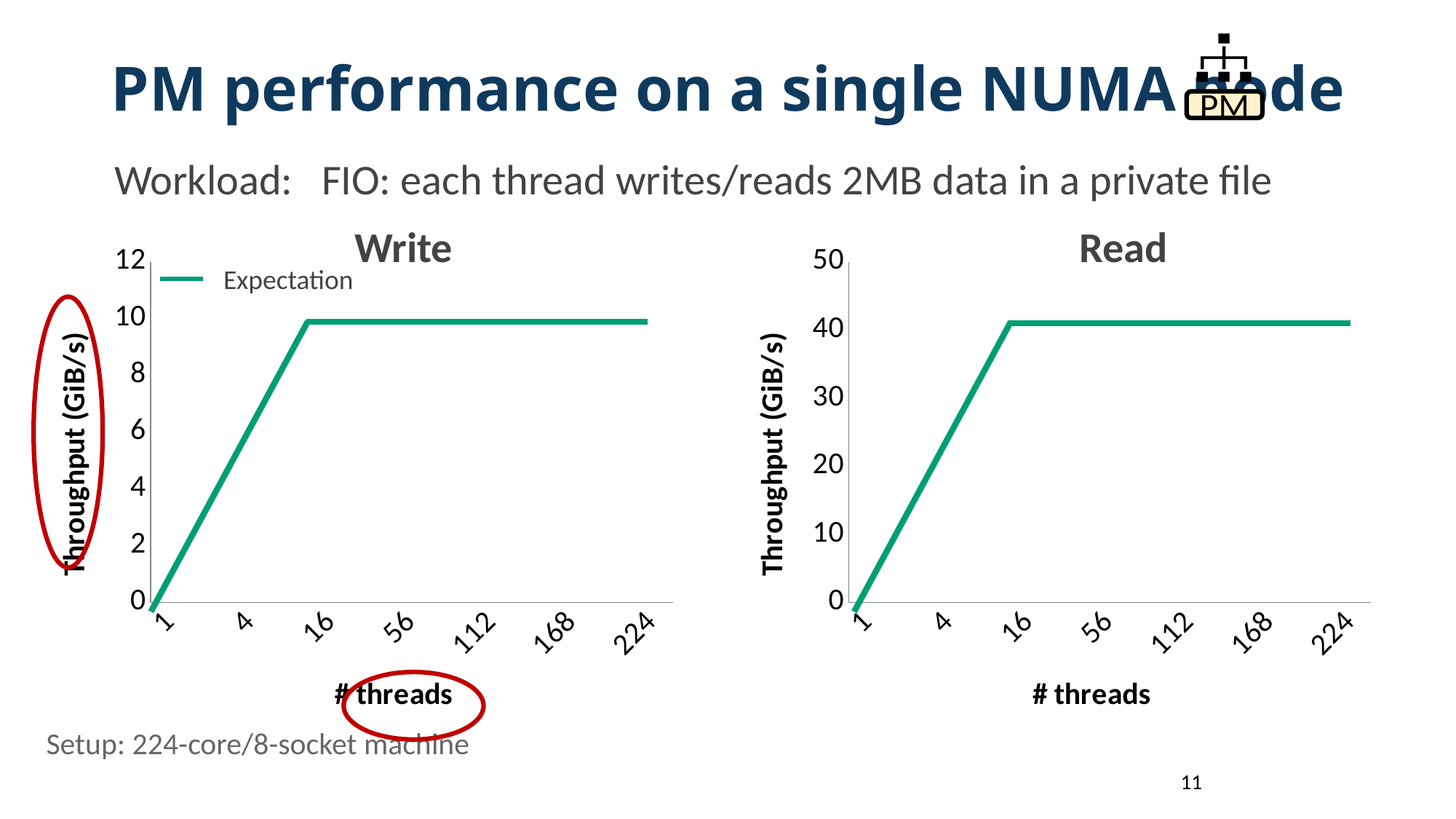
On the Read chart, is the throughput at 224 threads greater or less than 30 GiB/s? greater What is the name of the series shown in the legend of the Write chart? Expectation On the Write chart, is the throughput at 16 threads greater or less than 8 GiB/s? greater How many # threads values are marked on the x axis of the Read chart? 7 What is the y-axis label on the Read chart? Throughput (GiB/s) On the Read chart, does the throughput rise, fall, or stay flat between 16 and 224 threads? stay flat On the Write chart, does the throughput rise or fall between 1 and 16 threads? rise On the Read chart, is the throughput at 16 threads greater or less than 30 GiB/s? greater How many series does the legend on the Write chart list? 1 On the Write chart, which is larger, the throughput at 4 threads or at 56 threads? 56 threads What kind of chart is the Write chart? line chart